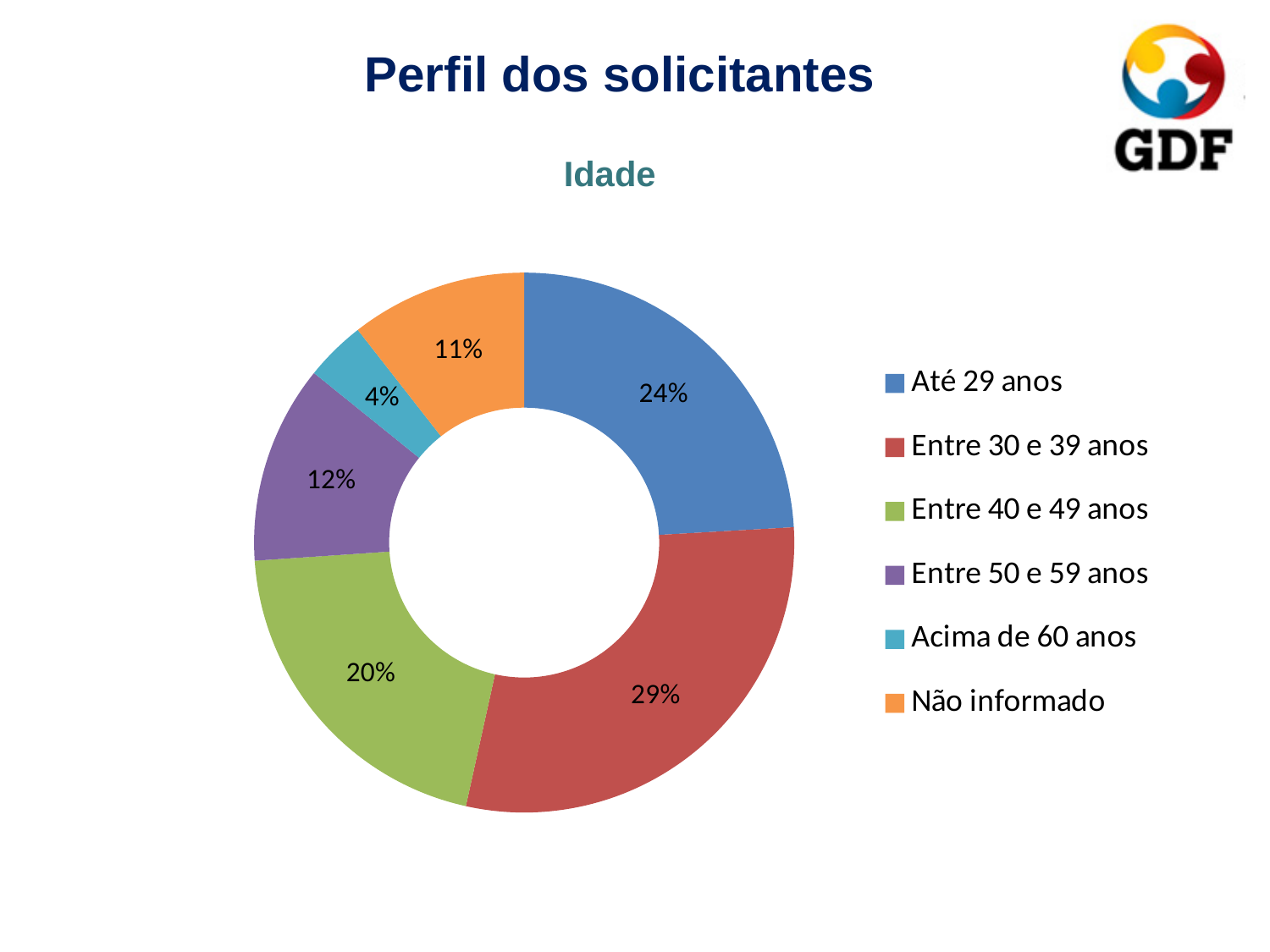
What is the value shown for 'Até 29 anos'? 24% Which is larger, the share for 'Entre 40 e 49 anos' or for 'Não informado'? Entre 40 e 49 anos What is the title of the chart? Idade Which colour represents 'Acima de 60 anos' in the legend? Light blue (cyan) What share of the chart does 'Entre 30 e 39 anos' represent? 29% What is the difference between the shares of 'Entre 30 e 39 anos' and 'Entre 50 e 59 anos'? 17% Which age category has the largest share? Entre 30 e 39 anos What is the value shown for 'Não informado'? 11% Which age category has the smallest share? Acima de 60 anos How many categories does the chart show? 6 What kind of chart is shown on the slide? Doughnut (pie) chart What is the value shown for 'Entre 40 e 49 anos'? 20%